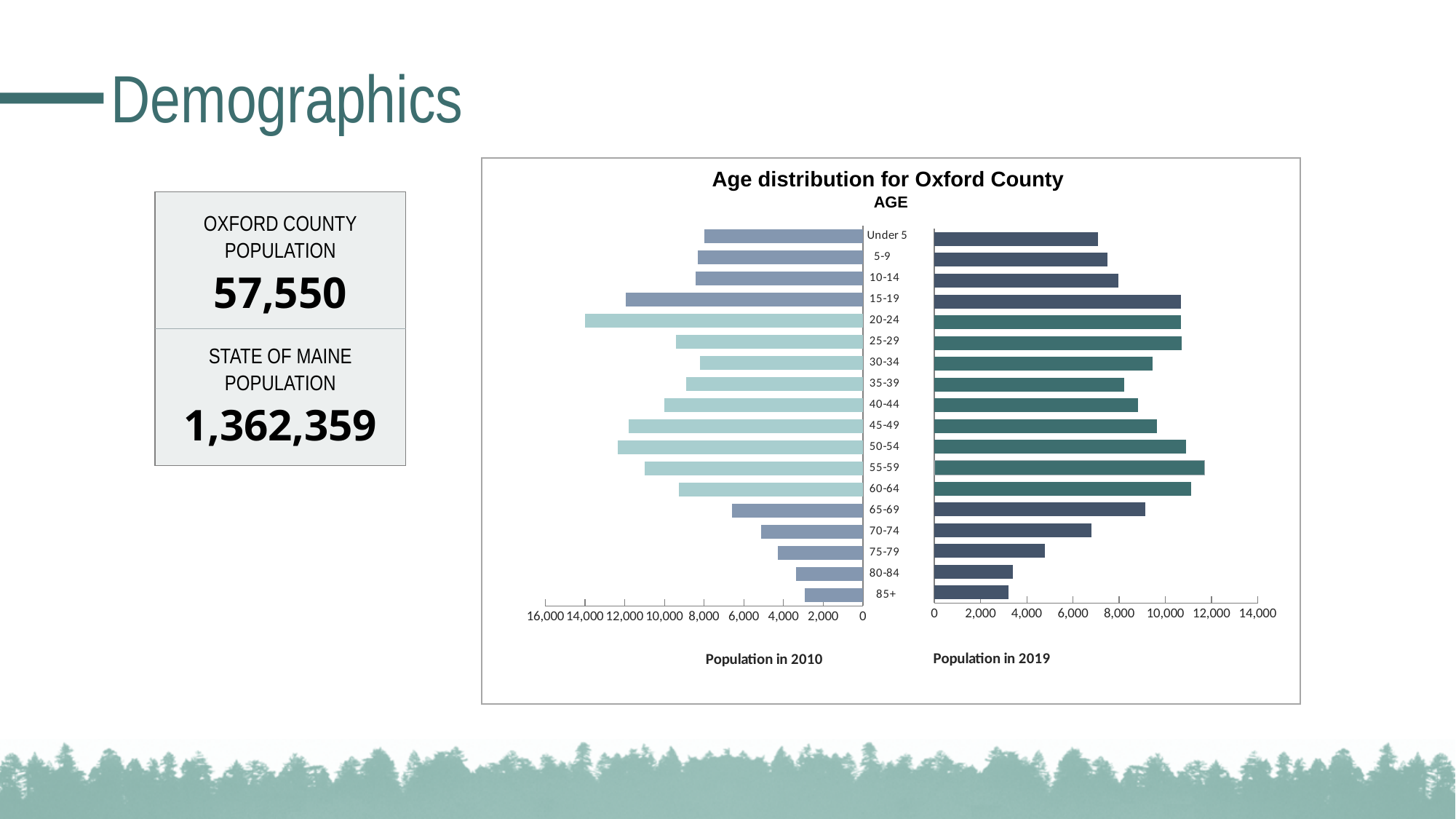
Which two years are compared in the chart? 2010 and 2019 In 2019, which age group has the larger population, 55-59 or Under 5? 55-59 Which age group has the smallest population in 2019? 85+ Is the population in 2019 for the 85+ age group greater or less than 4,000? less Which age group has the largest population in 2010? 20-24 Is the population in 2019 for the 55-59 age group greater or less than 10,000? greater What kind of chart is shown on the slide? bar chart How many age groups are shown in the chart? 18 Is the population in 2010 for the 20-24 age group greater or less than 12,000? greater Which age group has the smallest population in 2010? 85+ Which age group has the largest population in 2019? 55-59 What is the title of the chart? Age distribution for Oxford County